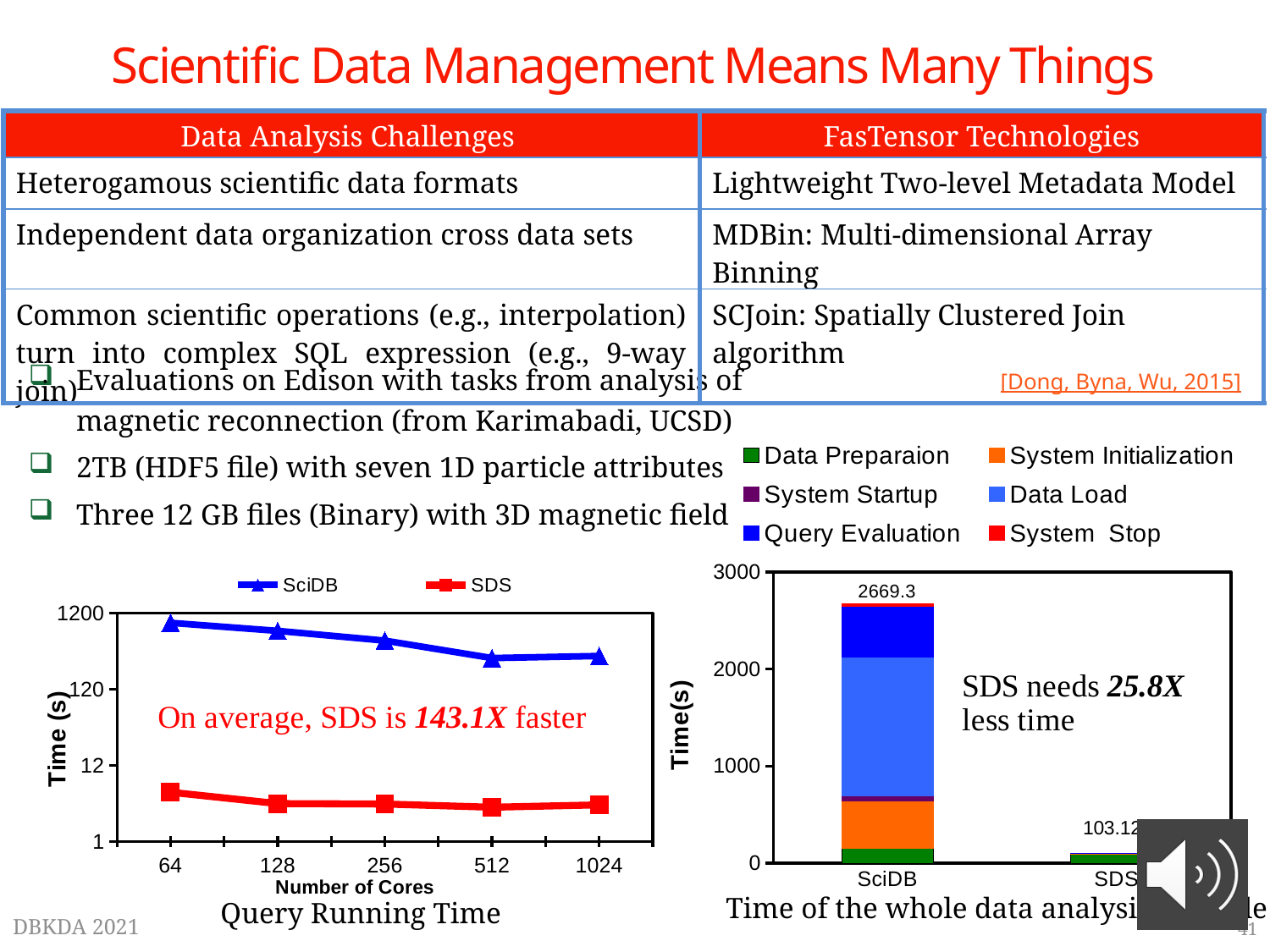
In the right chart "Time of the whole data analysis pipeline", how many series does the legend list? 6 In the left chart "Query Running Time", is the SDS time at 512 cores greater or less than 12 s? less In the left chart "Query Running Time", is the SciDB time at 64 cores greater or less than 120 s? greater In the left chart "Query Running Time", how many series does the legend list? 2 What type of chart is the left chart titled "Query Running Time"? line chart In the right chart "Time of the whole data analysis pipeline", what is the total time labeled for SciDB? 2669.3 In the left chart "Query Running Time", how many core counts are shown on the x axis? 5 In the right chart "Time of the whole data analysis pipeline", what is the total time labeled for SDS? 103.12 In the left chart "Query Running Time", which series has the higher time at 64 cores, SciDB or SDS? SciDB In the right chart "Time of the whole data analysis pipeline", which system has the higher total time, SciDB or SDS? SciDB In the left chart "Query Running Time", does the SciDB time generally rise or fall as the number of cores increases from 64 to 512? fall What type of chart is the right chart titled "Time of the whole data analysis pipeline"? stacked bar chart